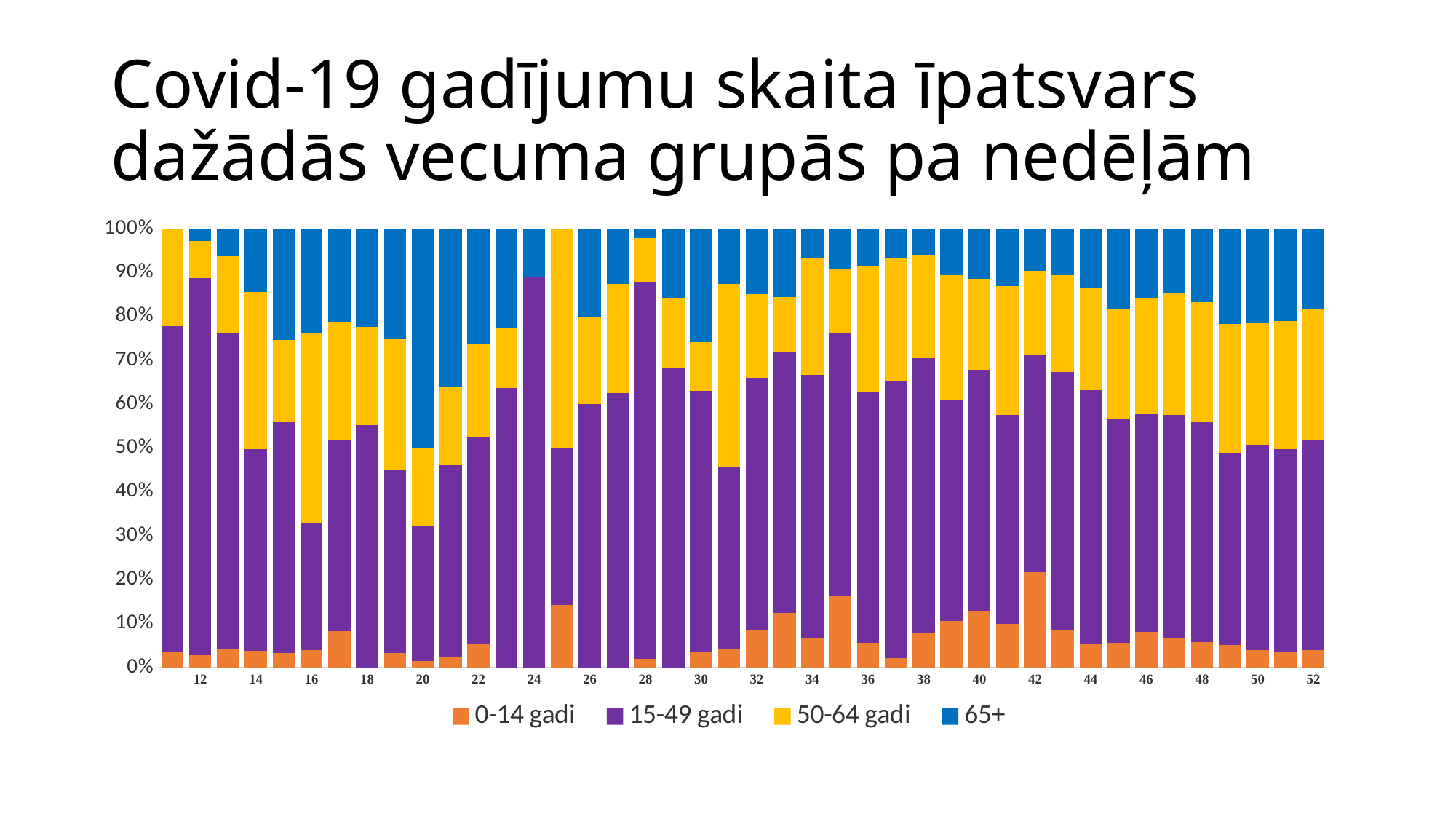
What is the title of the chart? Covid-19 gadījumu skaita īpatsvars dažādās vecuma grupās pa nedēļām Which week has a larger share for the 65+ group, week 20 or week 25? 20 Which week has the largest share for the 0-14 gadi group? 42 What kind of chart is shown on the slide? Stacked bar chart How many series does the legend list? 4 Which week has the largest share for the 65+ group? 20 Is the share of the 65+ group in week 20 greater or less than 40%? greater Which week has a larger share for the 0-14 gadi group, week 12 or week 42? 42 What is the total of the stacked bar for week 30? 100% Is the share of the 65+ group in week 25 greater or less than 10%? less Is the share of the 0-14 gadi group in week 42 greater or less than 20%? greater Which age group is shown in orange in the legend? 0-14 gadi